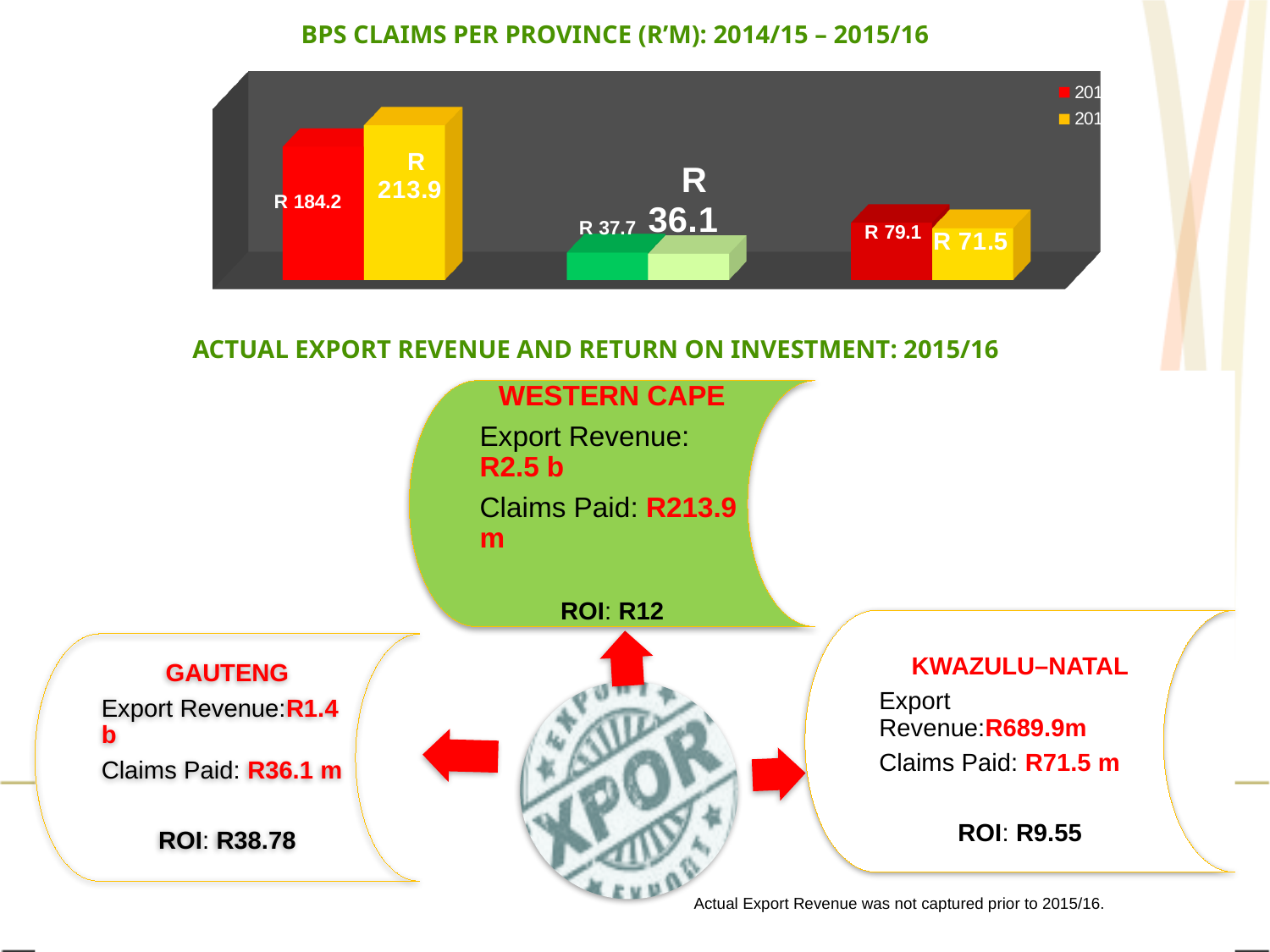
Which bar in the chart has the highest value? the yellow bar in the left-hand group (R 213.9) What is the difference between the two bars in the left-hand group of the chart? R 29.7 What is the value of the yellow bar in the left-hand group of the chart? R 213.9 What is the value of the first (darker green) bar in the middle group of the chart? R 37.7 What is the value of the yellow bar in the right-hand group of the chart? R 71.5 How many groups of bars are plotted in the chart? 3 In the right-hand group of the chart, which bar is larger, the red one or the yellow one? the red one (R 79.1) What is the value of the red bar in the left-hand group of the chart? R 184.2 How many series does the chart's legend list? 2 What is the value of the second bar in the middle group of the chart? R 36.1 What is the title of the chart at the top of the slide? BPS CLAIMS PER PROVINCE (R'M): 2014/15 – 2015/16 What type of chart is shown at the top of the slide? bar chart